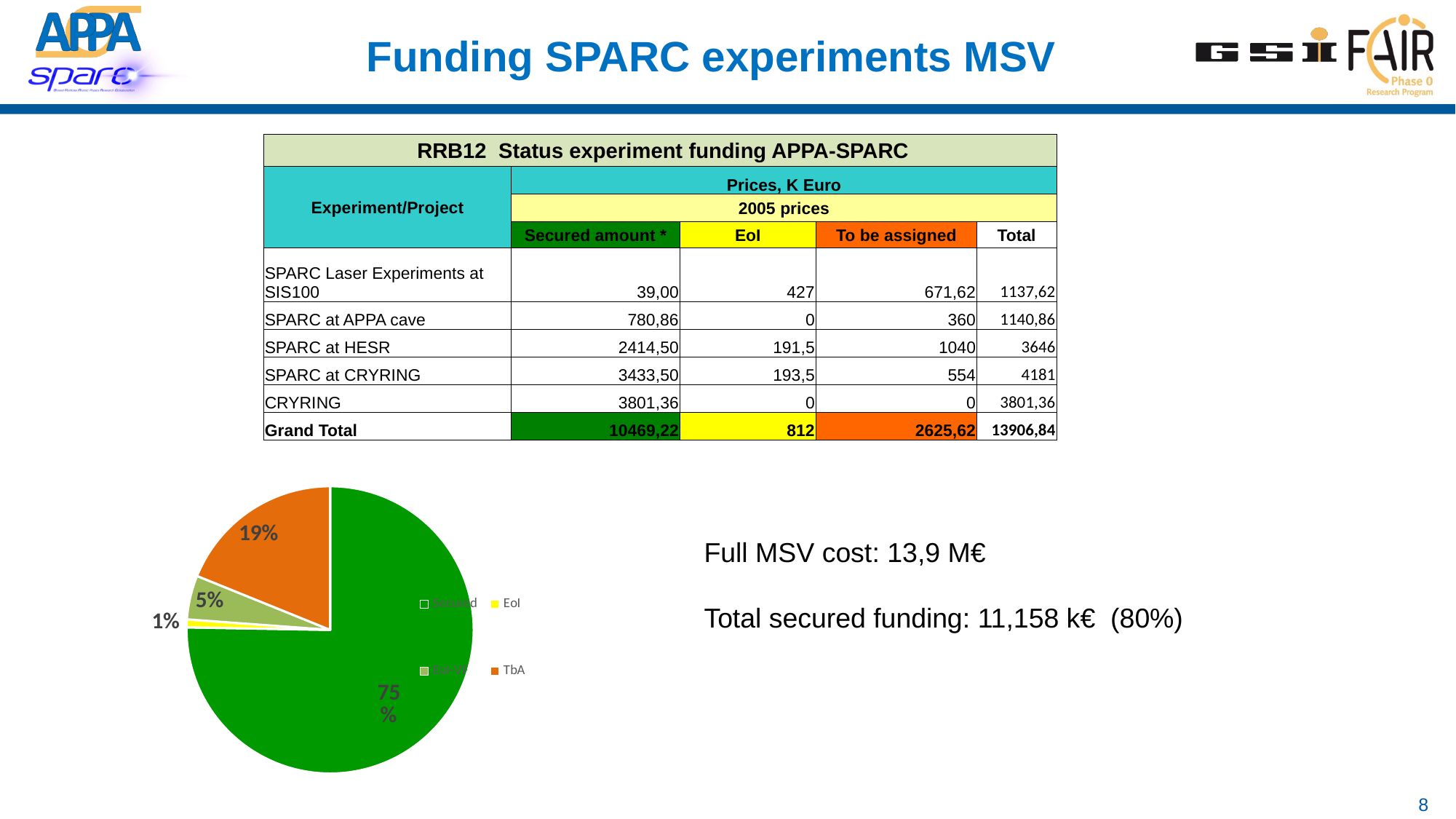
What colour is the TbA slice of the pie chart? orange How many entries does the pie chart's legend list? 4 What share of the pie does the largest slice represent? 75% Which slice is larger, TbA or EoI? TbA What share of the pie does the EoI slice represent? 1% What colour is the largest slice of the pie chart? green Which legend entry corresponds to the largest slice of the pie? Secured How many slices does the pie chart have? 4 What kind of chart is shown on the slide? pie chart What is the difference in percentage points between the 75% slice and the 19% slice? 56 Which legend entry corresponds to the smallest slice of the pie? EoI What share of the pie does the TbA slice represent? 19%